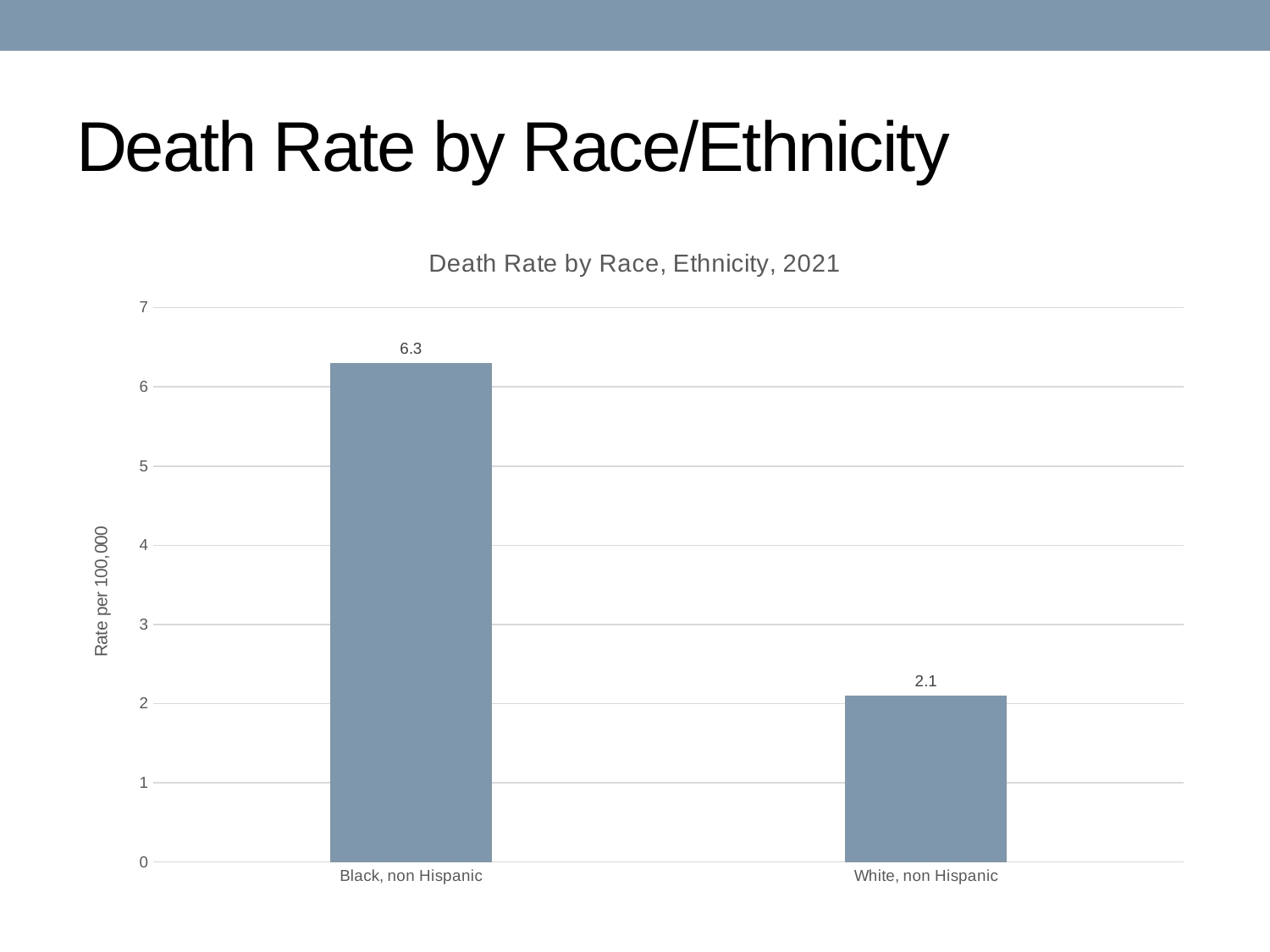
What kind of chart is shown on the slide? Bar chart Which category has the lowest death rate? White, non Hispanic Which category has the highest death rate? Black, non Hispanic Is the value for White, non Hispanic greater or less than 3? less Which is larger, the death rate for Black, non Hispanic or for White, non Hispanic? Black, non Hispanic How many categories are shown on the chart? 2 What is the death rate for White, non Hispanic? 2.1 What is the label of the vertical axis? Rate per 100,000 What is the title of the chart? Death Rate by Race, Ethnicity, 2021 Is the value for Black, non Hispanic greater or less than 6? greater What is the death rate for Black, non Hispanic? 6.3 What is the difference between the death rates for Black, non Hispanic and White, non Hispanic? 4.2